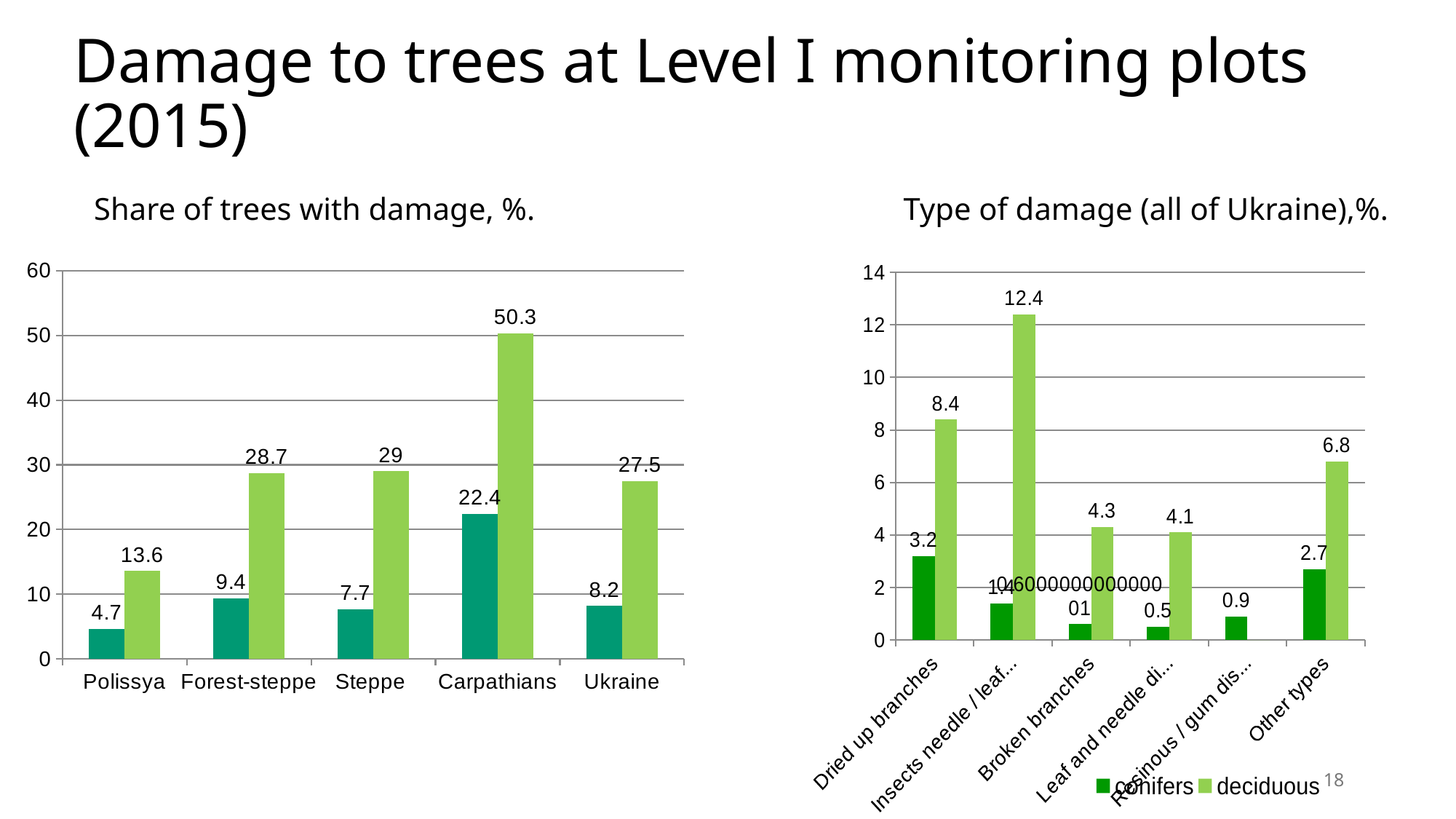
In the 'Type of damage (all of Ukraine),%.' chart, what is the conifers value for 'Dried up branches'? 3.2 In the 'Share of trees with damage, %.' chart, which region has the lowest dark teal bar? Polissya In the 'Type of damage (all of Ukraine),%.' chart, what is the deciduous value for 'Insects needle / leaf...'? 12.4 In the 'Share of trees with damage, %.' chart, what is the difference between the light green and dark teal bars for Carpathians? 27.9 In the 'Type of damage (all of Ukraine),%.' chart, which damage type has the highest deciduous value? Insects needle / leaf... In the 'Share of trees with damage, %.' chart, what is the value of the dark teal bar for Polissya? 4.7 How many regions are shown on the x axis of the 'Share of trees with damage, %.' chart? 5 In the 'Share of trees with damage, %.' chart, is the light green bar for Carpathians greater or less than 40? greater How many series does the legend of the 'Type of damage (all of Ukraine),%.' chart list? 2 In the 'Type of damage (all of Ukraine),%.' chart, what is the difference between the deciduous and conifers values for 'Dried up branches'? 5.2 In the 'Share of trees with damage, %.' chart, which region has the highest light green bar? Carpathians In the 'Share of trees with damage, %.' chart, what is the value of the light green bar for Carpathians? 50.3